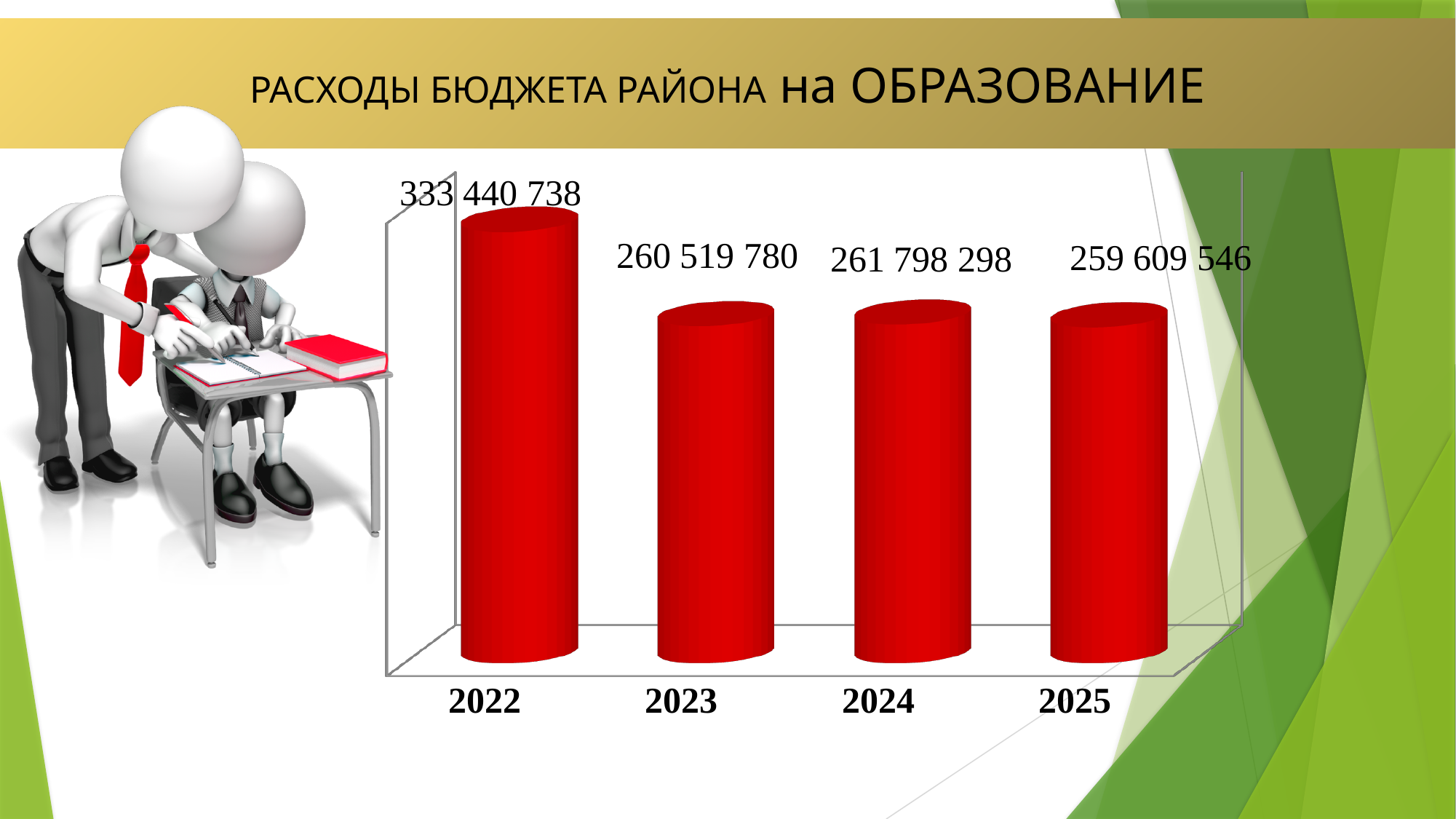
How many years are shown on the chart? 4 What is the value shown for 2024? 261 798 298 Which is larger, the value for 2023 or the value for 2024? 2024 What is the value shown for 2023? 260 519 780 Which year has the highest value? 2022 What is the value shown for 2025? 259 609 546 What is the difference between the values for 2022 and 2023? 72 920 958 What kind of chart is shown on the slide? Bar chart Which year has the lowest value? 2025 What is the title of the slide? РАСХОДЫ БЮДЖЕТА РАЙОНА на ОБРАЗОВАНИЕ What is the difference between the values for 2024 and 2025? 2 188 752 What is the value shown for 2022? 333 440 738